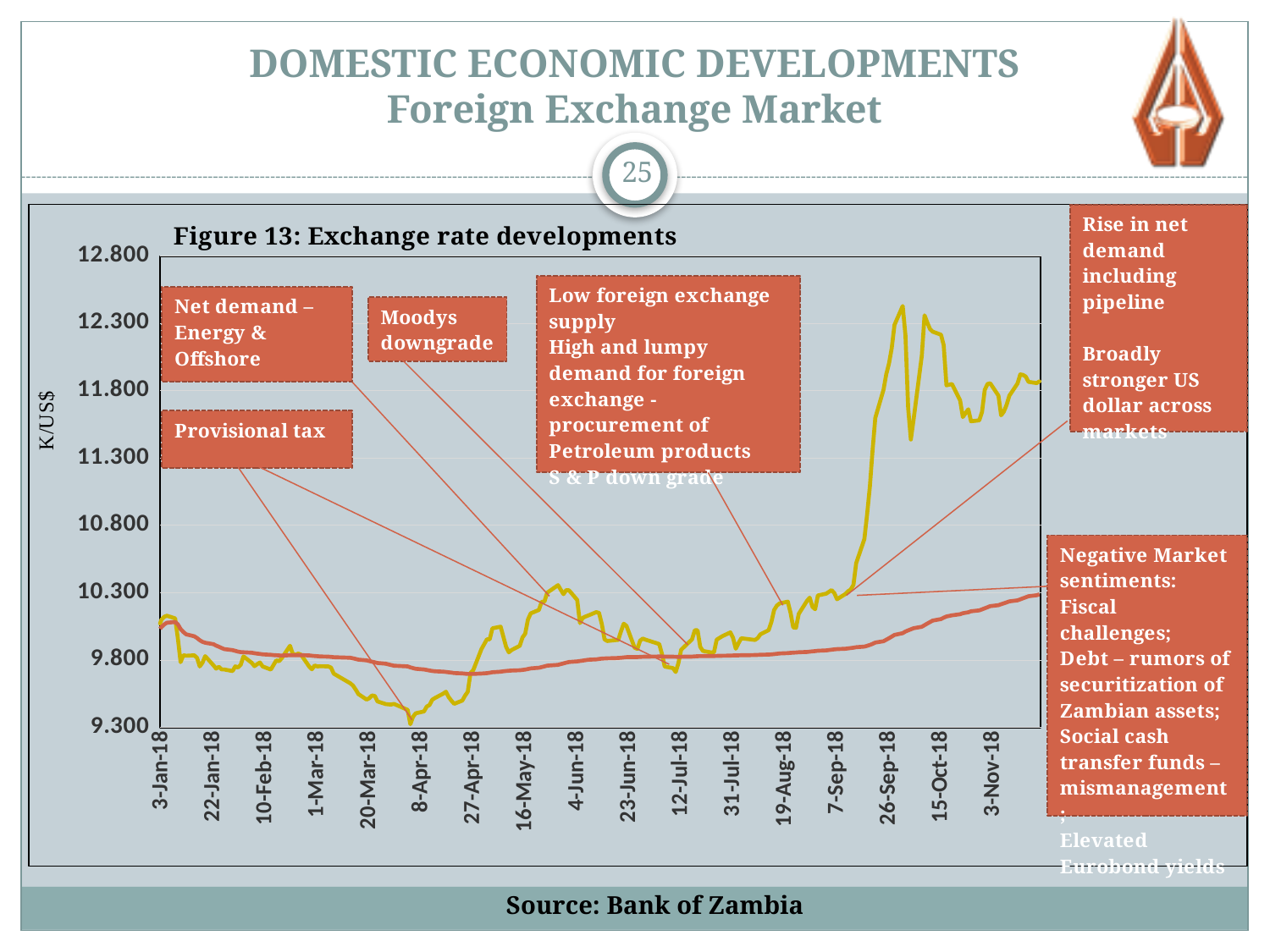
Is the value of the yellow line at 8-Apr-18 greater or less than 9.800? less Does the yellow line rise or fall between 3-Jan-18 and 8-Apr-18? fall Is the value of the yellow line at 3-Jan-18 greater or less than 10.300? less Is the peak value of the yellow line around 26-Sep-18 greater or less than 12.300? greater What is the label on the vertical axis of the chart? K/US$ How many date labels are shown on the x axis of the chart? 17 What type of chart is Figure 13: Exchange rate developments? line chart What is the title of the chart on the slide? Figure 13: Exchange rate developments Does the orange line rise or fall between 20-Mar-18 and 3-Nov-18? rise